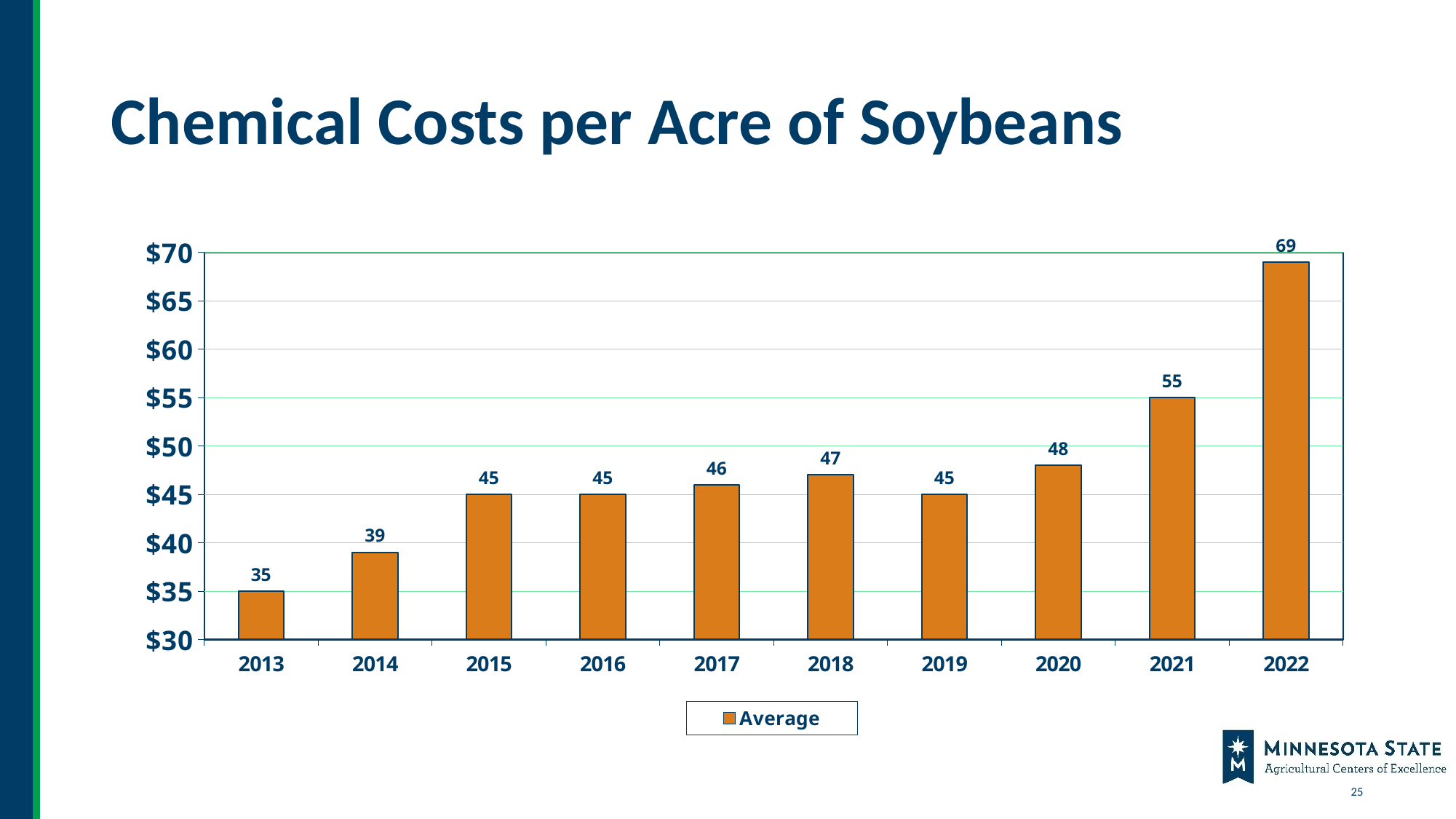
How many years are shown on the x axis? 10 Which year has the lowest chemical cost per acre? 2013 What is the value shown for 2018? 47 Is the value for 2021 greater or less than $50? greater What is the title of the chart? Chemical Costs per Acre of Soybeans What is the value shown for 2022? 69 What is the difference between the values for 2022 and 2021? 14 Which year has a larger value, 2014 or 2020? 2020 What kind of chart is shown on the slide? bar chart Which year has the highest chemical cost per acre? 2022 How many series does the legend list? 1 What is the chemical cost per acre of soybeans in 2013? 35